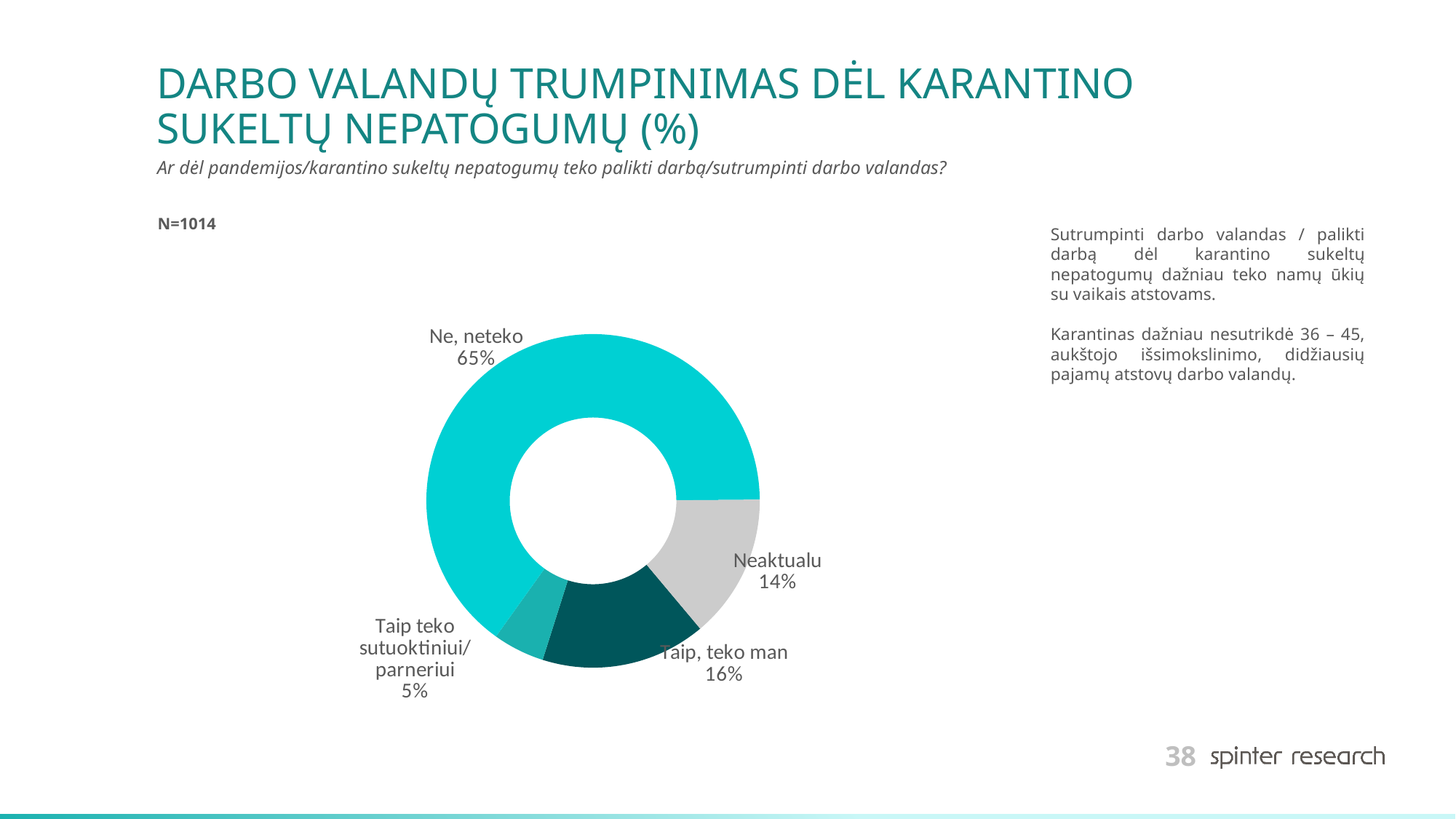
What is the combined share of "Taip, teko man" and "Taip teko sutuoktiniui/parneriui"? 21% What is the difference in percentage points between "Ne, neteko" and "Taip, teko man"? 49 What sample size (N) is stated on the slide? N=1014 Which category has the largest share of the chart? Ne, neteko Which is larger: the share for "Taip, teko man" or the share for "Neaktualu"? Taip, teko man What type of chart is shown on the slide? Pie chart (doughnut) Which category has the smallest share of the chart? Taip teko sutuoktiniui/parneriui What percentage of respondents answered "Neaktualu"? 14% How many categories are shown in the chart? 4 What percentage of respondents answered "Ne, neteko"? 65% What percentage of respondents answered "Taip teko sutuoktiniui/parneriui"? 5% What percentage of respondents answered "Taip, teko man"? 16%